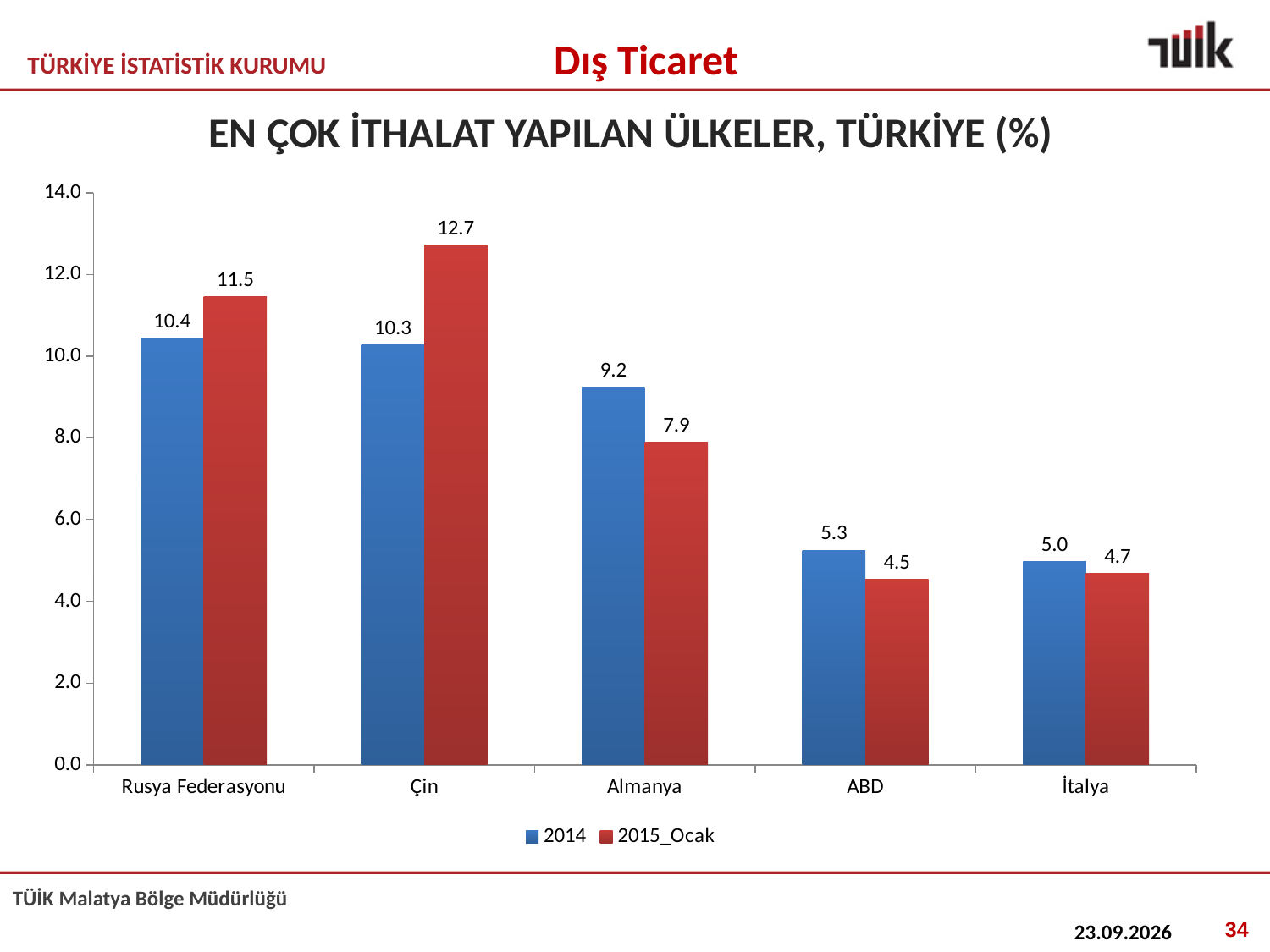
What is the 2015_Ocak value for Almanya? 7.9 What is the 2015_Ocak value for Çin? 12.7 What is the 2014 value for Rusya Federasyonu? 10.4 Which country has the lowest 2015_Ocak value? ABD Which is larger for Almanya, the 2014 value or the 2015_Ocak value? 2014 How many countries are shown on the x axis? 5 What is the difference between the 2015_Ocak and 2014 values for Çin? 2.4 What is the title of the chart? EN ÇOK İTHALAT YAPILAN ÜLKELER, TÜRKİYE (%) Which country has the highest 2015_Ocak value? Çin Is the 2014 value for ABD greater or less than 6.0? less What kind of chart is shown on the slide? bar chart How many series does the legend list? 2